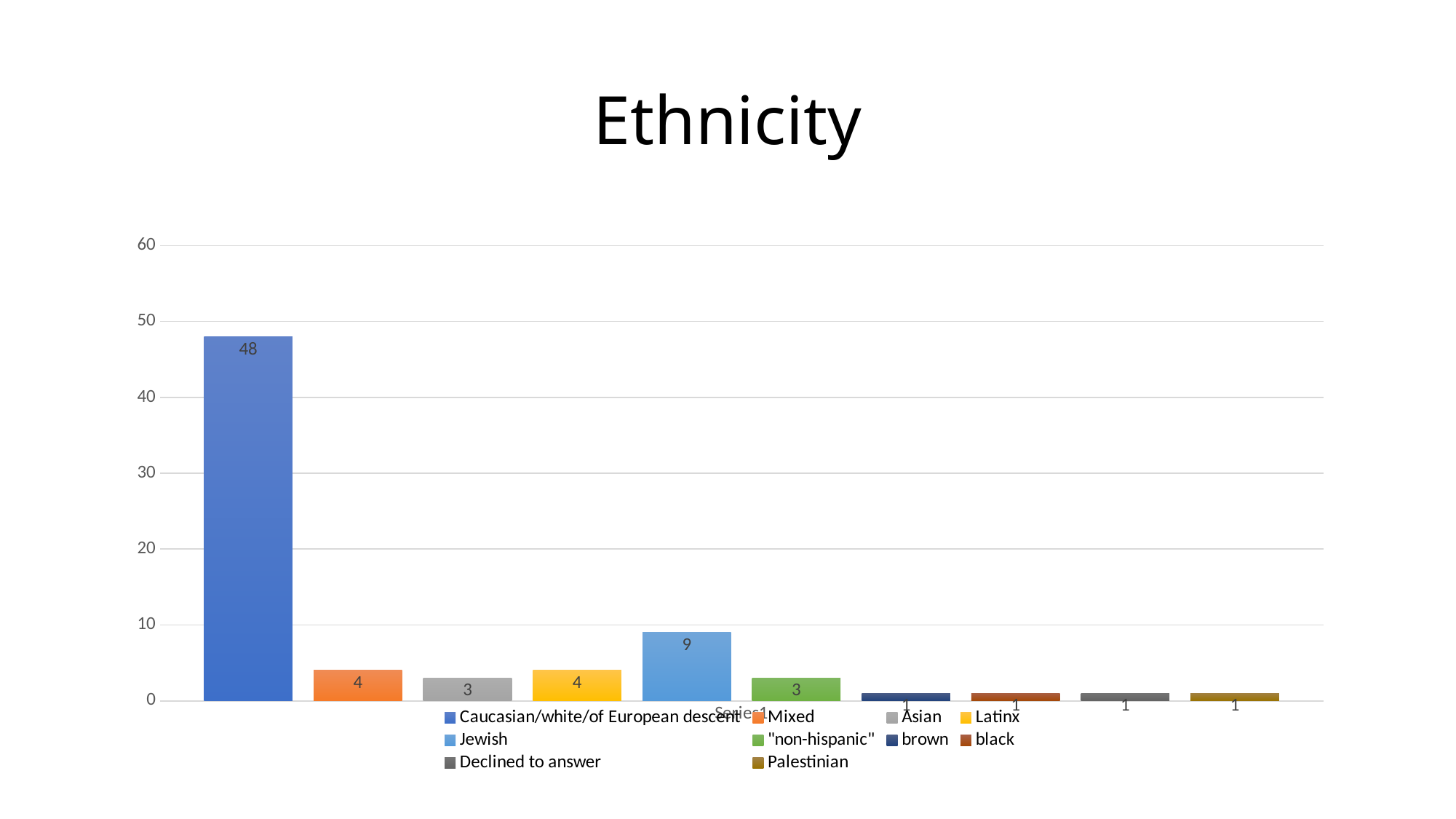
What is the value for Caucasian/white/of European descent? 48 Which category has the highest value? Caucasian/white/of European descent What is the difference between the values for Caucasian/white/of European descent and Jewish? 39 How many bars are plotted in the chart? 10 What is the value for Jewish? 9 Which is larger, the value for Jewish or the value for Mixed? Jewish What is the difference between the values for Jewish and Latinx? 5 What is the value for Palestinian? 1 What is the value for Asian? 3 What is the value for Mixed? 4 What kind of chart is shown on the slide? bar chart Is the value for Caucasian/white/of European descent greater or less than 40? greater